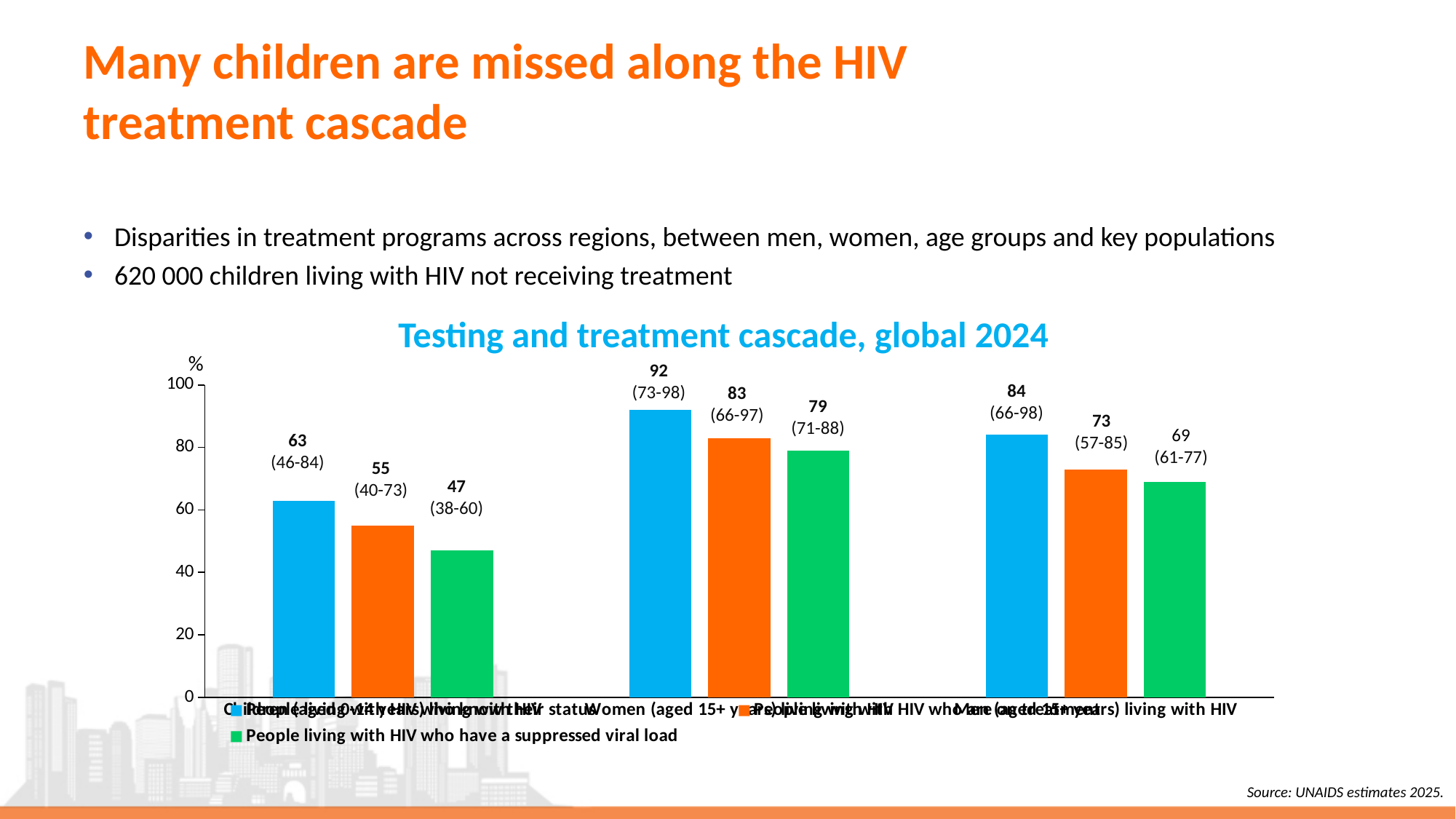
In the chart 'Testing and treatment cascade, global 2024', what is the difference between the blue bar for Women and the blue bar for Men? 8 In the chart 'Testing and treatment cascade, global 2024', which is larger: the orange bar for Children or the green bar for Men? The green bar for Men (69) In the chart 'Testing and treatment cascade, global 2024', what is the value of the green bar for Children (aged 0-14 years) living with HIV? 47 In the chart 'Testing and treatment cascade, global 2024', which bar has the highest value? The blue bar for Women (aged 15+ years) living with HIV, 92 In the chart 'Testing and treatment cascade, global 2024', what range is printed under the green bar for Women (aged 15+ years) living with HIV? (71-88) How many series does the legend of the chart 'Testing and treatment cascade, global 2024' list? 3 How many population groups are shown on the x axis of the chart 'Testing and treatment cascade, global 2024'? 3 In the chart 'Testing and treatment cascade, global 2024', what is the value of the blue bar for Women (aged 15+ years) living with HIV? 92 In the chart 'Testing and treatment cascade, global 2024', do the values within each group rise or fall from the blue bar to the green bar? Fall In the chart 'Testing and treatment cascade, global 2024', what is the value of the orange bar for Men (aged 15+ years) living with HIV? 73 In the chart 'Testing and treatment cascade, global 2024', which bar has the lowest value? The green bar for Children (aged 0-14 years) living with HIV, 47 What kind of chart is 'Testing and treatment cascade, global 2024'? Bar chart